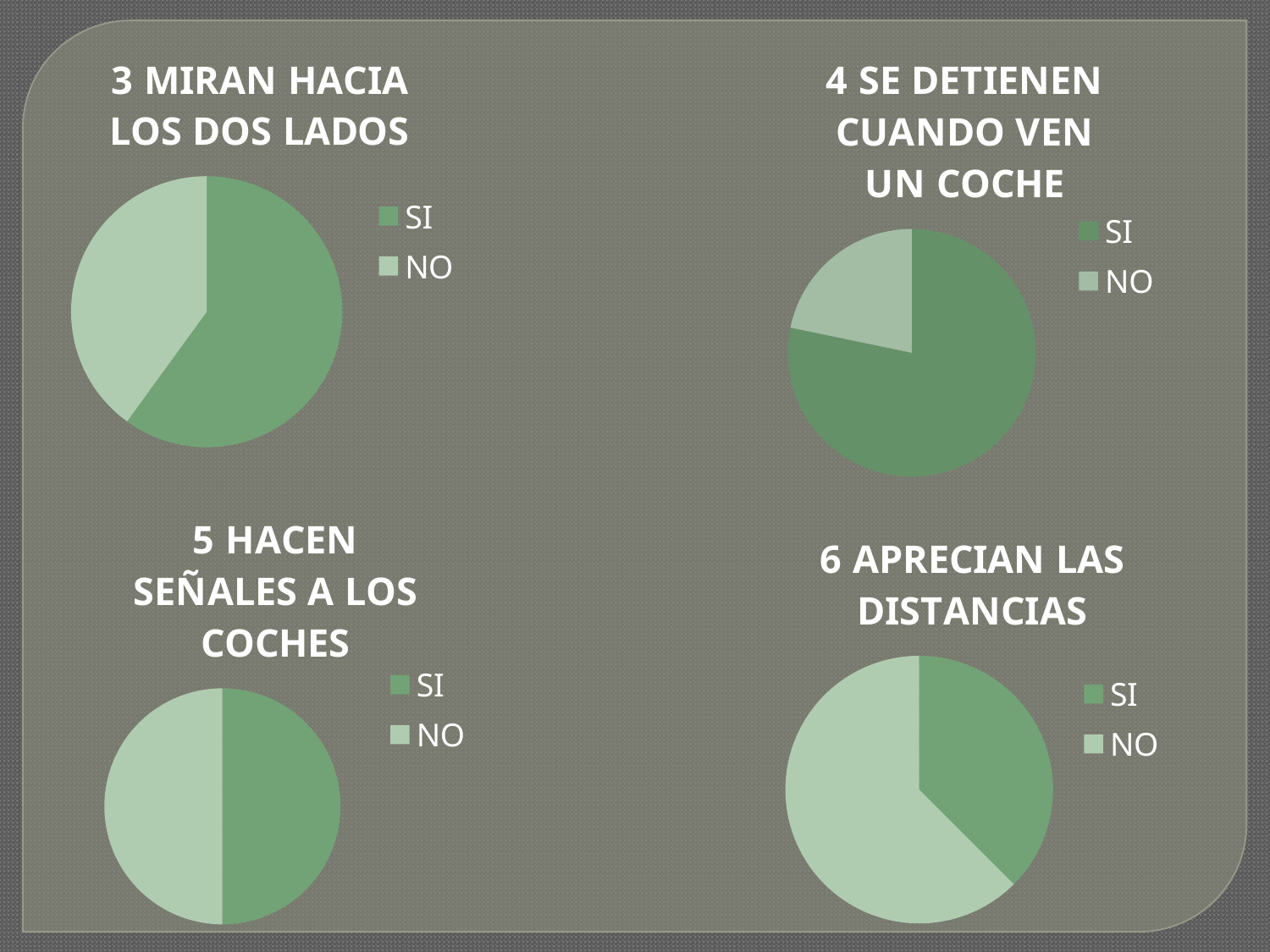
What is the title of the pie chart in the bottom-left of the slide? 5 HACEN SEÑALES A LOS COCHES In the chart titled "4 SE DETIENEN CUANDO VEN UN COCHE", how many entries does the legend list? 2 In the chart titled "6 APRECIAN LAS DISTANCIAS", which slice is larger, SI or NO? NO In the chart titled "4 SE DETIENEN CUANDO VEN UN COCHE", which slice is larger, SI or NO? SI How many pie charts are shown on the slide? 4 What kind of chart is used in the chart titled "3 MIRAN HACIA LOS DOS LADOS"? Pie chart In the chart titled "6 APRECIAN LAS DISTANCIAS", which category has the largest slice? NO In the chart titled "3 MIRAN HACIA LOS DOS LADOS", which slice is larger, SI or NO? SI In the chart titled "3 MIRAN HACIA LOS DOS LADOS", how many slices does the pie have? 2 In the chart titled "4 SE DETIENEN CUANDO VEN UN COCHE", which category has the smallest slice? NO What are the two legend entries in the chart titled "6 APRECIAN LAS DISTANCIAS"? SI and NO